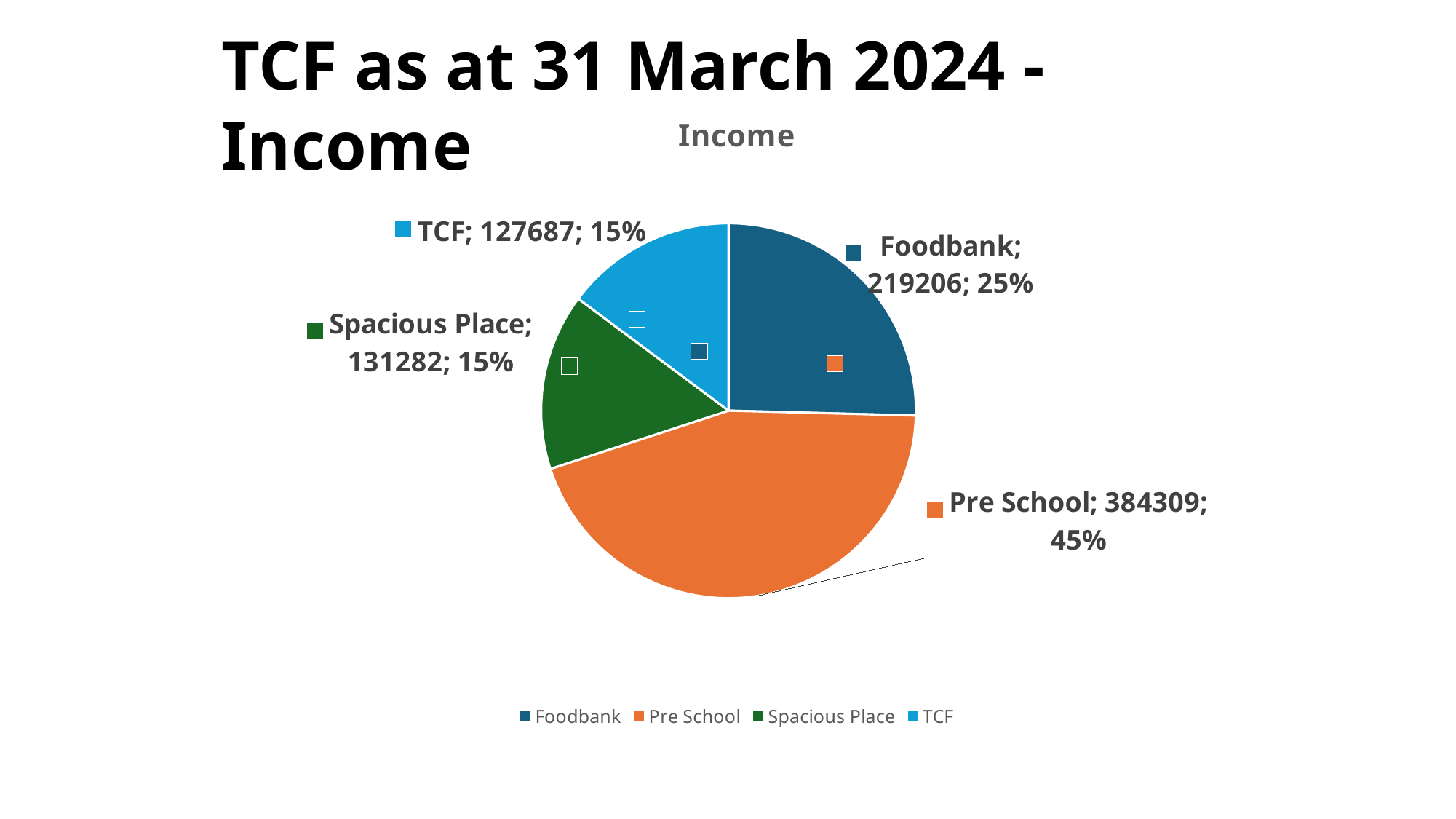
Which has a larger income value, Spacious Place or TCF? Spacious Place What is the income value for Pre School? 384309 What percentage share of income does Pre School account for? 45% Which category has the smallest income value? TCF What is the income value for Spacious Place? 131282 Which category has the largest share of income? Pre School What is the income value for TCF? 127687 What percentage share of income does Foodbank account for? 25% What is the income value for Foodbank? 219206 How many categories are shown in the pie chart? 4 What is the difference between the Pre School and Foodbank income values? 165103 What type of chart is shown on the slide? Pie chart